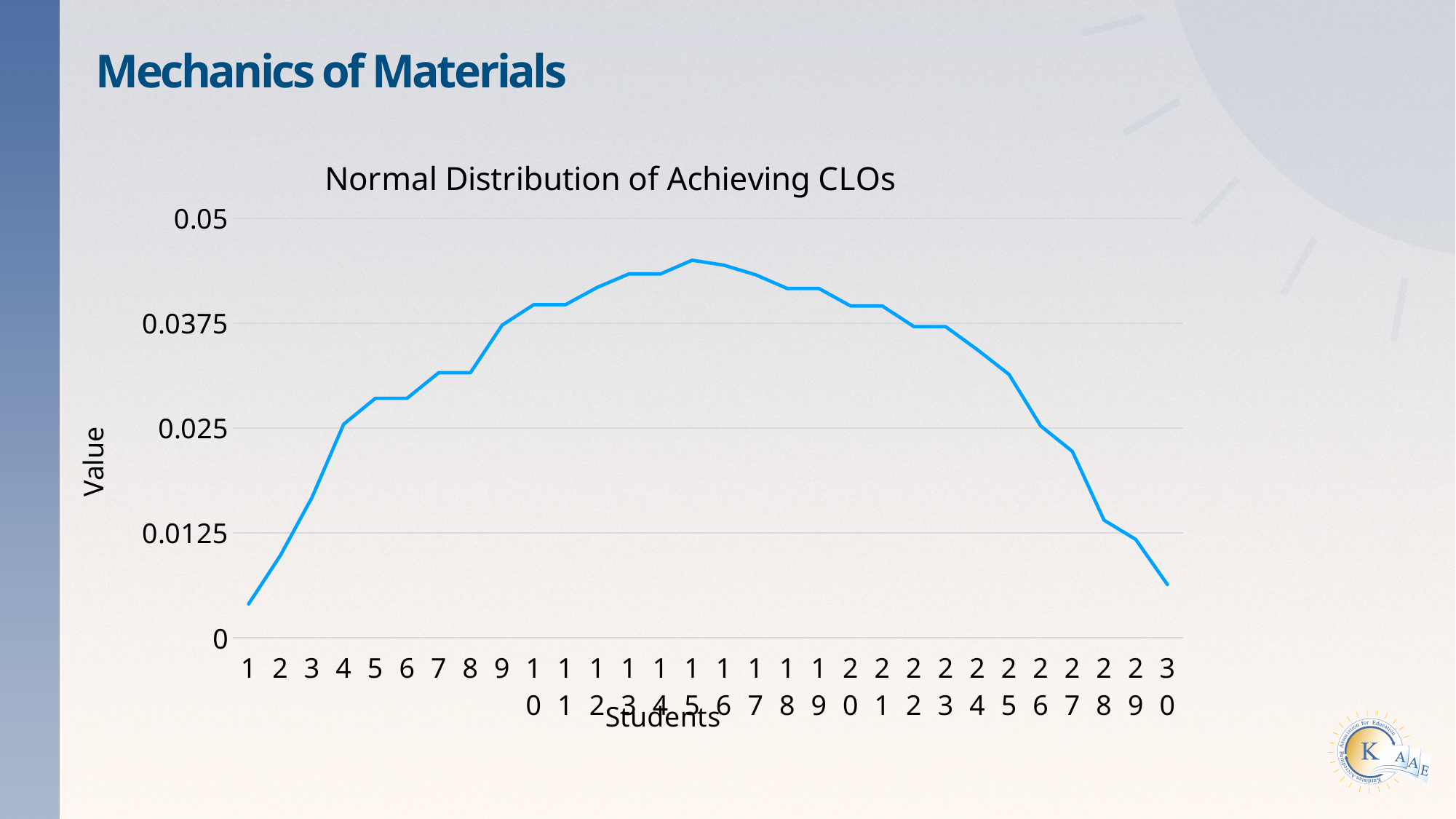
Which student has the lowest value on the chart? 1 What kind of chart is shown on the slide? line chart Is the value for student 15 greater or less than 0.0375? greater Which has the larger value, student 3 or student 28? student 3 Do the values rise or fall from student 15 to student 30? fall What is the title of the chart? Normal Distribution of Achieving CLOs What is the label of the x axis of the chart? Students Is the value for student 30 greater or less than 0.0125? less Which student has the highest value on the chart? 15 Is the value for student 1 greater or less than 0.0125? less How many students (data points) are plotted along the x axis? 30